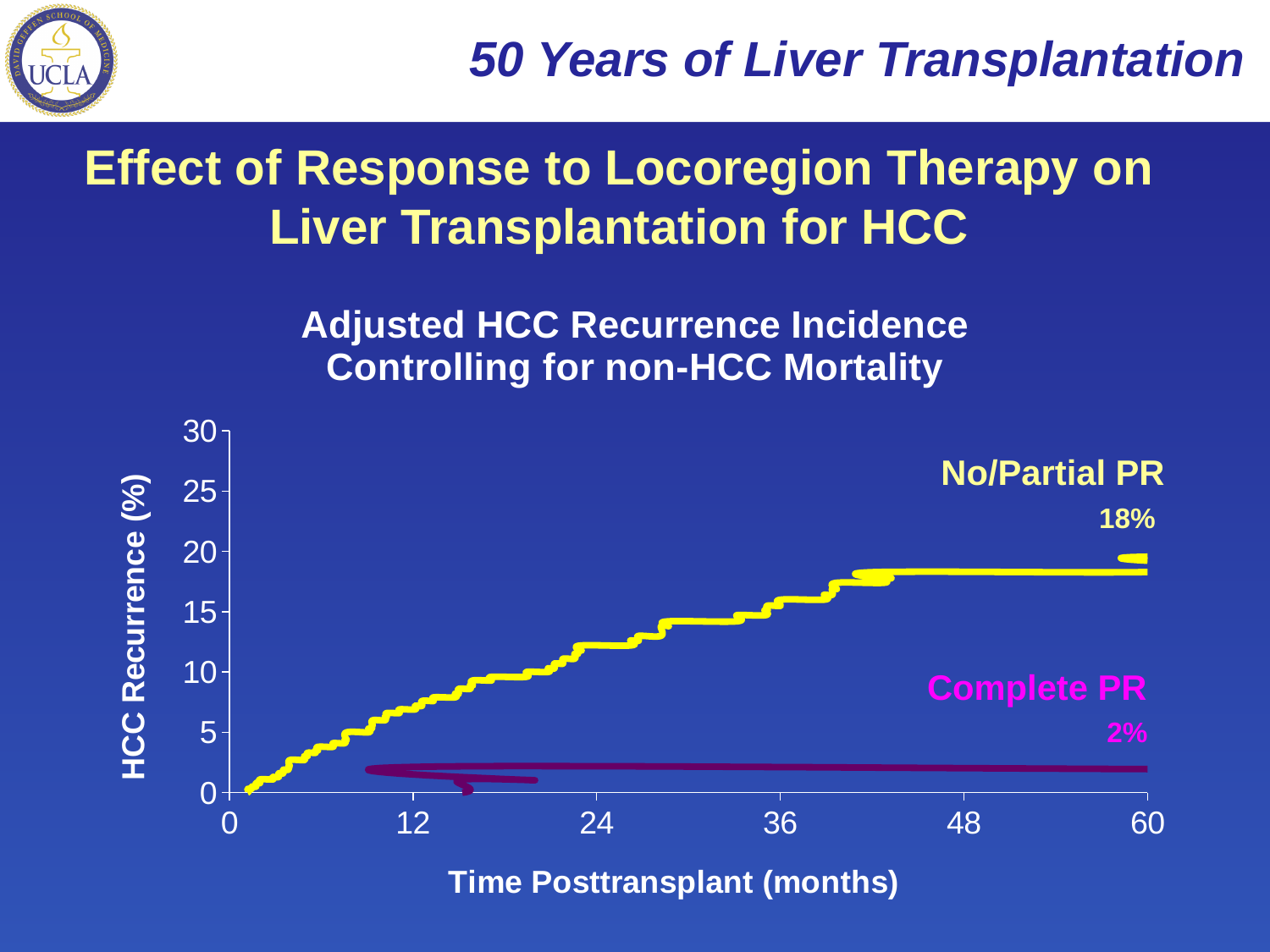
What is the difference between the labeled HCC recurrence values for No/Partial PR and Complete PR? 16% Which group has the lower HCC recurrence at the end of follow-up? Complete PR What is the HCC recurrence value labeled for the Complete PR group? 2% Is the HCC recurrence for Complete PR at 60 months greater or less than 5? less What is the title of the chart? Adjusted HCC Recurrence Incidence Controlling for non-HCC Mortality What is the HCC recurrence value labeled for the No/Partial PR group? 18% What is the label of the x axis? Time Posttransplant (months) Is the HCC recurrence for No/Partial PR at 60 months greater or less than 15? greater How many groups (series) are plotted on the chart? 2 What type of chart is shown on the slide? line chart Which group has the higher HCC recurrence at the end of follow-up? No/Partial PR Does the No/Partial PR curve rise or fall over time posttransplant? rise